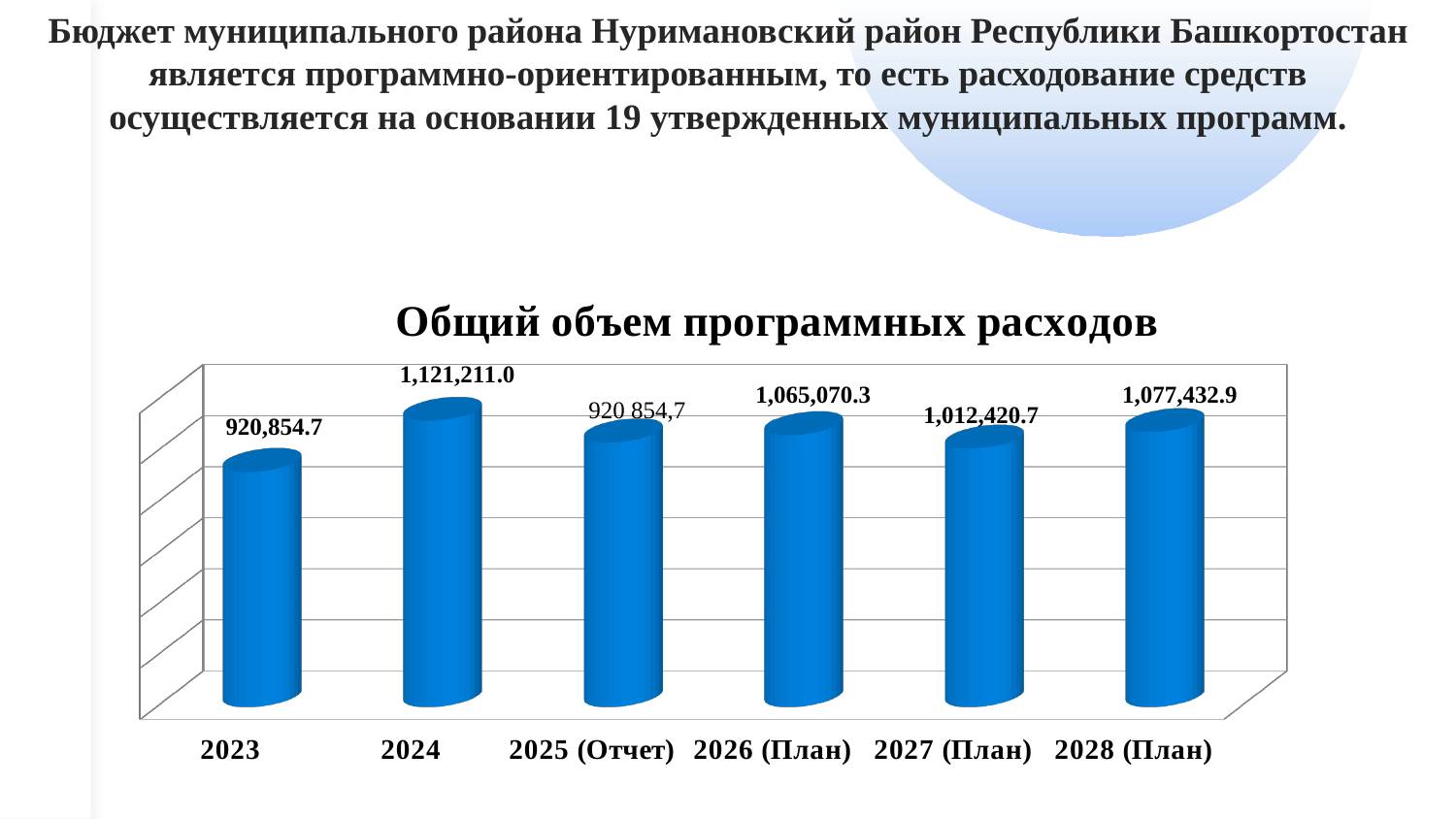
What is the value for 2028 (План)? 1,077,432.9 What is the title of the chart? Общий объем программных расходов What is the value for 2024? 1,121,211.0 What is the difference between the values for 2028 (План) and 2027 (План)? 65,012.2 Which year has the highest value in the chart? 2024 What is the value for 2026 (План)? 1,065,070.3 How many categories are shown on the x axis of the chart? 6 What is the value for 2023 in the chart "Общий объем программных расходов"? 920,854.7 Which is larger, the value for 2026 (План) or 2027 (План)? 2026 (План) What is the value for 2027 (План)? 1,012,420.7 What is the difference between the values for 2024 and 2023? 200,356.3 What kind of chart is shown on the slide? Bar chart